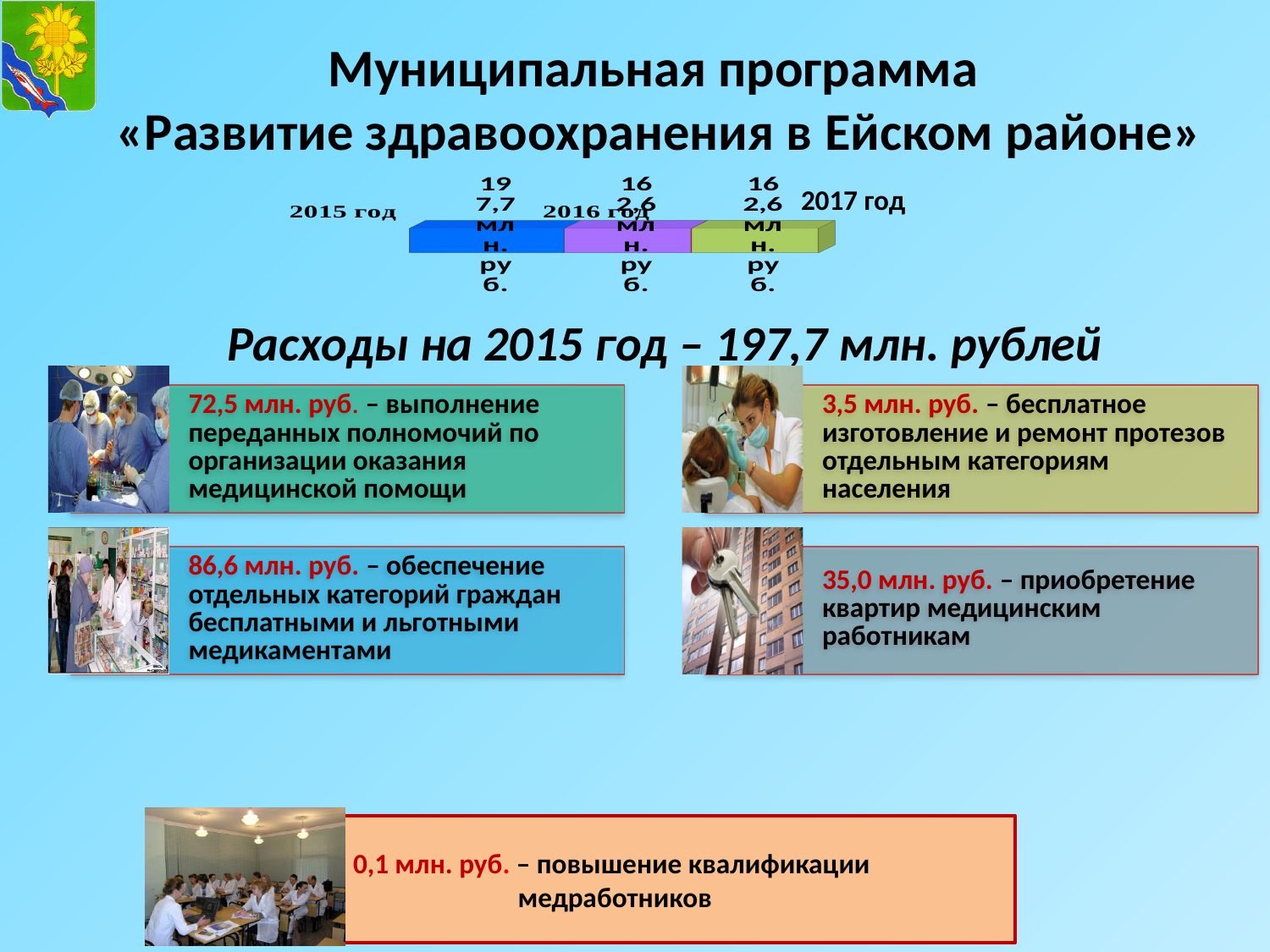
What value is shown for 2016 год in the bar chart? 162,6 млн. руб. What colour is the bar for 2015 год? Blue Which year has the highest value in the bar chart? 2015 год How many bars are shown in the chart? 3 What value is shown for 2015 год in the bar chart? 197,7 млн. руб. What colour is the bar for 2017 год? Green Does the value fall or rise from 2015 год to 2016 год in the bar chart? Falls What value is shown for 2017 год in the bar chart? 162,6 млн. руб. What is the difference between the values for 2015 год and 2016 год in the bar chart? 35,1 млн. руб. What kind of chart is shown at the top of the slide? Bar chart Which is larger in the bar chart, the value for 2015 год or for 2016 год? 2015 год